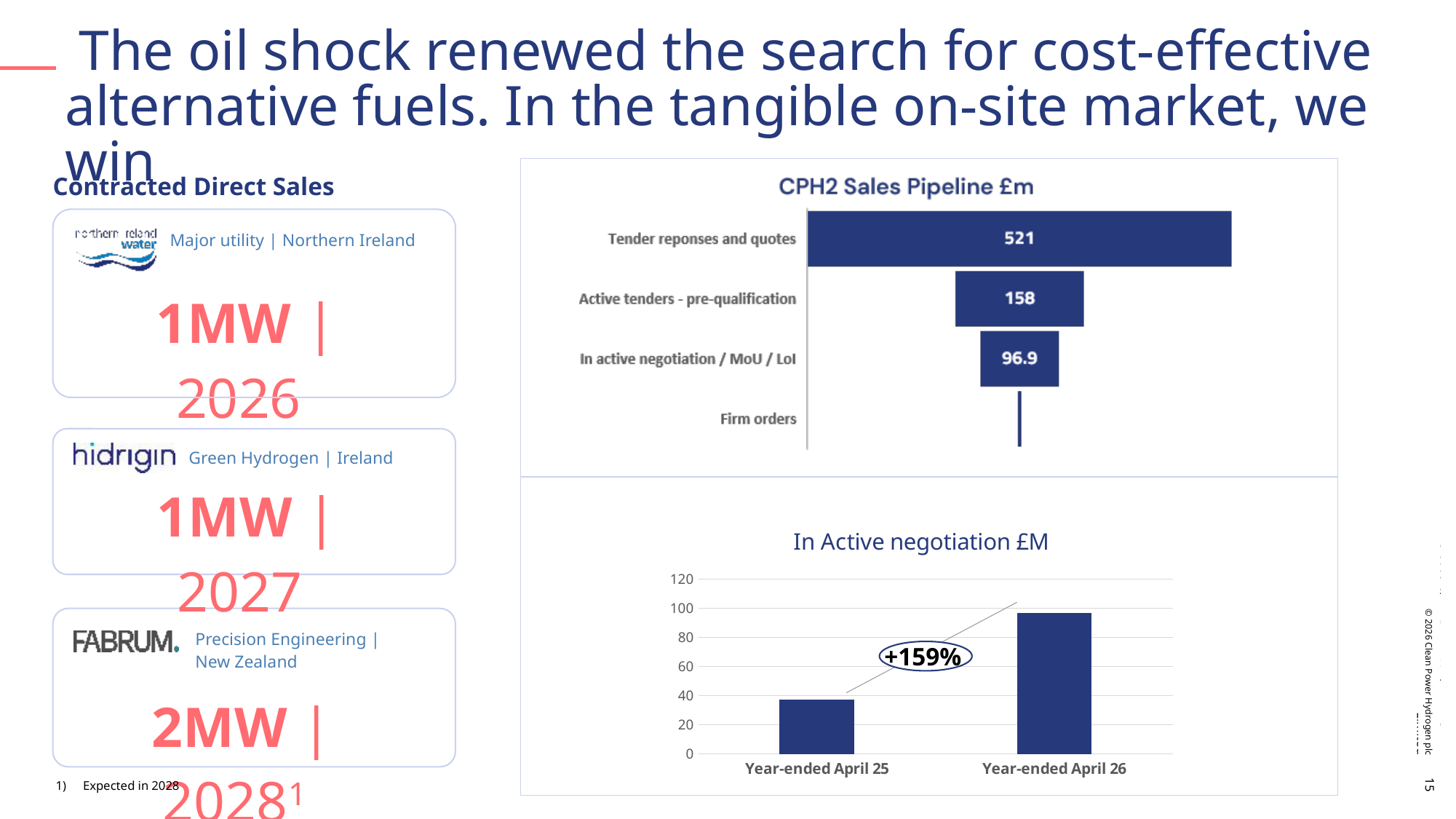
In the CPH2 Sales Pipeline £m chart, what is the value for In active negotiation / MoU / LoI? 96.9 In the In Active negotiation £M chart, is the value for Year-ended April 25 greater or less than 60? less In the In Active negotiation £M chart, is the value for Year-ended April 26 greater or less than 80? greater In the CPH2 Sales Pipeline £m chart, which is larger: Active tenders - pre-qualification or In active negotiation / MoU / LoI? Active tenders - pre-qualification In the CPH2 Sales Pipeline £m chart, which category has the highest value? Tender responses and quotes In the CPH2 Sales Pipeline £m chart, what is the difference between Tender responses and quotes and Active tenders - pre-qualification? 363 In the CPH2 Sales Pipeline £m chart, what is the value for Active tenders - pre-qualification? 158 What kind of chart is the CPH2 Sales Pipeline £m chart? Bar chart What percentage change is annotated between the two bars in the In Active negotiation £M chart? +159% How many categories are shown in the CPH2 Sales Pipeline £m chart? 4 In the In Active negotiation £M chart, do the values rise or fall from Year-ended April 25 to Year-ended April 26? rise In the CPH2 Sales Pipeline £m chart, what is the value for Tender responses and quotes? 521